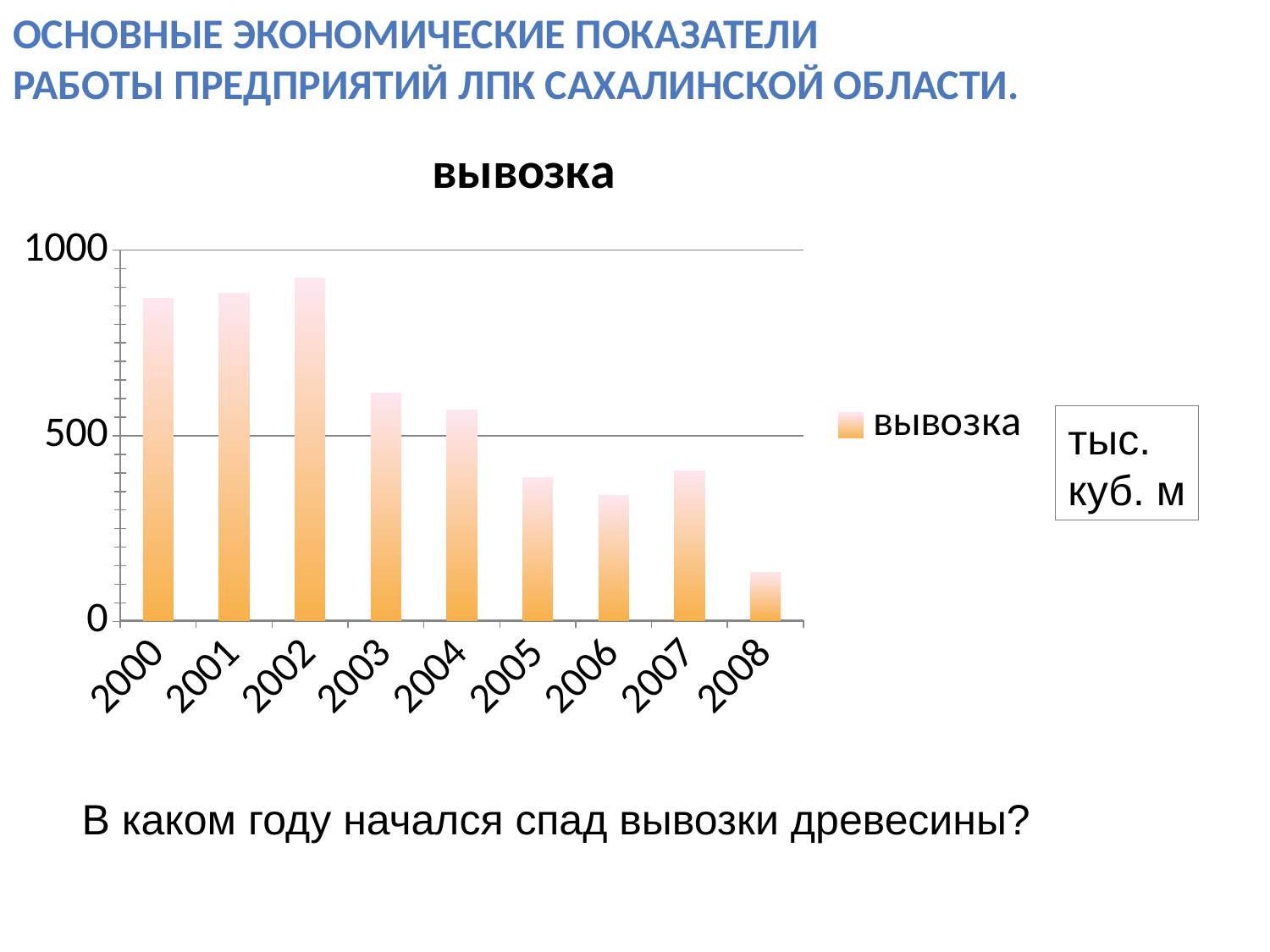
How many years (categories) are shown on the x axis of the chart? 9 Is the value for 2008 greater or less than 500? less How many series does the chart legend list? 1 Is the value for 2003 greater or less than 500? greater Which year has the highest value in the chart? 2002 Which year has the larger value, 2003 or 2005? 2003 What is the title of the chart? вывозка Do the values generally rise or fall from 2000 to 2008? fall Is the value for 2005 greater or less than 500? less What kind of chart is shown on the slide? bar chart Which year has the lowest value in the chart? 2008 What unit is indicated in the box next to the chart? тыс. куб. м